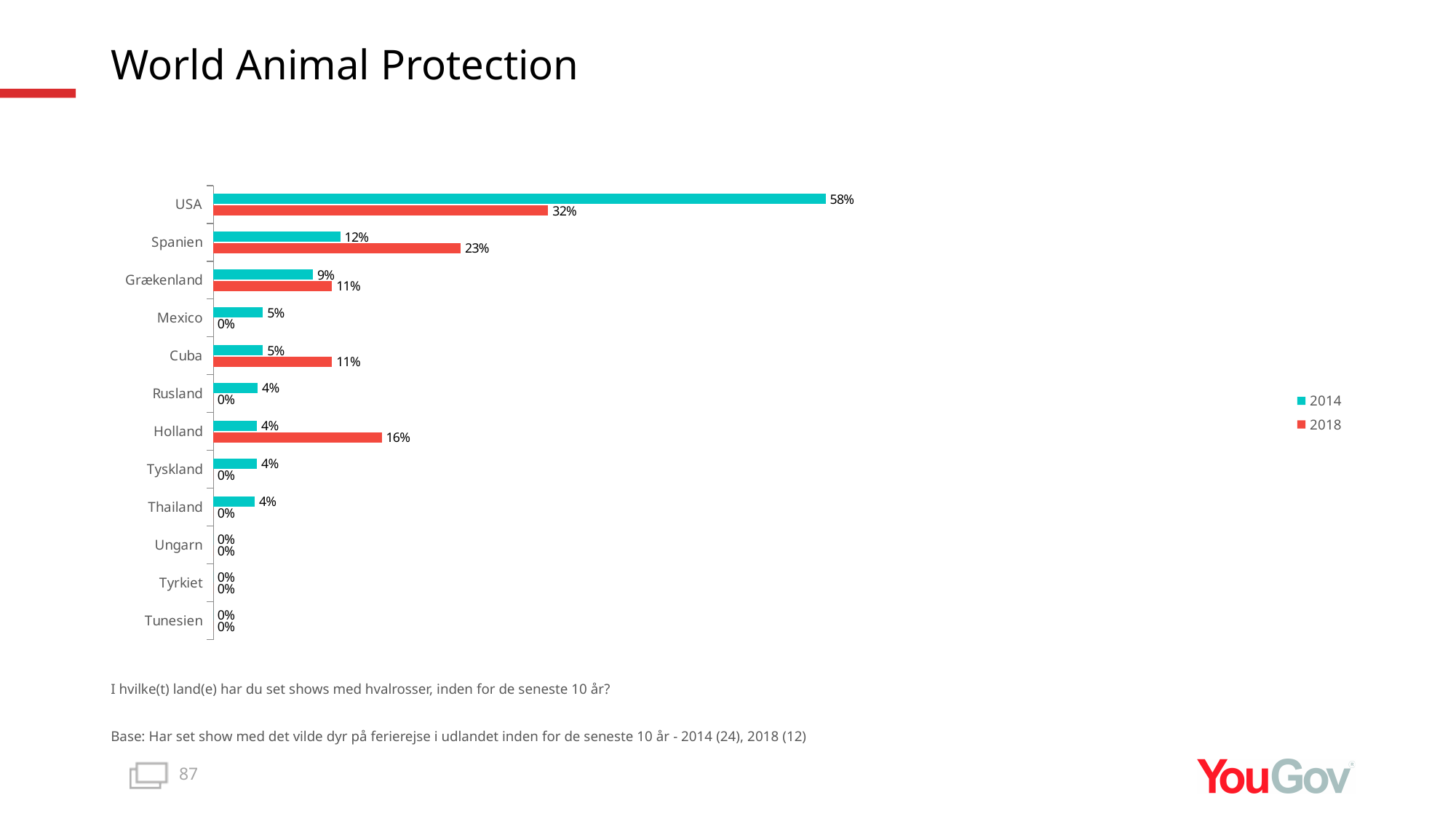
How many series does the legend list? 2 Which country has the highest 2018 value? USA What is the difference between the 2018 and 2014 values for Spanien? 11% What is the difference between the 2014 and 2018 values for USA? 26% What is the 2014 value for USA? 58% What kind of chart is shown on the slide? Bar chart Which is larger for Cuba, the 2014 value or the 2018 value? 2018 What is the 2018 value for Holland? 16% What is the 2014 value for Grækenland? 9% How many countries are shown on the chart? 12 What is the 2018 value for Spanien? 23% Which is larger for Mexico, the 2014 value or the 2018 value? 2014